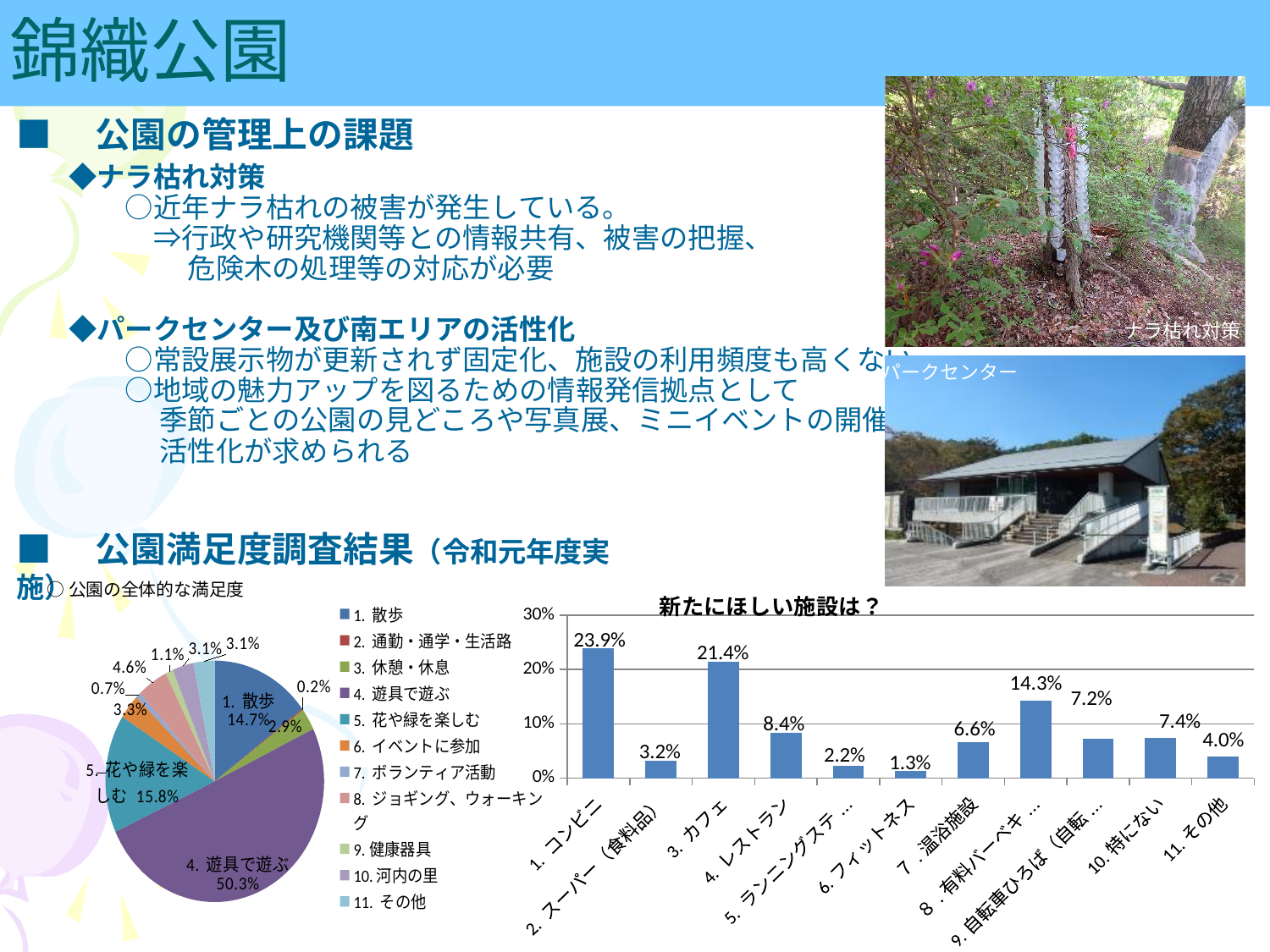
In the bar chart titled 新たにほしい施設は？, what is the value for 1. コンビニ? 23.9% What kind of chart is the chart titled 新たにほしい施設は？? Bar chart In the bar chart titled 新たにほしい施設は？, how many categories are shown? 11 In the bar chart titled 新たにほしい施設は？, which is larger: the value for 4. レストラン or the value for 7. 温浴施設? 4. レストラン In the bar chart titled 新たにほしい施設は？, what is the value for 10. 特にない? 7.4% In the pie chart on the left of the slide, which category has the largest slice? 4. 遊具で遊ぶ In the bar chart titled 新たにほしい施設は？, which category has the lowest value? 6. フィットネス In the bar chart titled 新たにほしい施設は？, what is the value for 3. カフェ? 21.4% In the bar chart titled 新たにほしい施設は？, which category has the highest value? 1. コンビニ In the pie chart on the left of the slide, what is the difference between the shares for 5. 花や緑を楽しむ and 1. 散歩? 1.1% In the bar chart titled 新たにほしい施設は？, what is the difference between the values for 1. コンビニ and 3. カフェ? 2.5% In the pie chart on the left of the slide, what is the share for 4. 遊具で遊ぶ? 50.3%